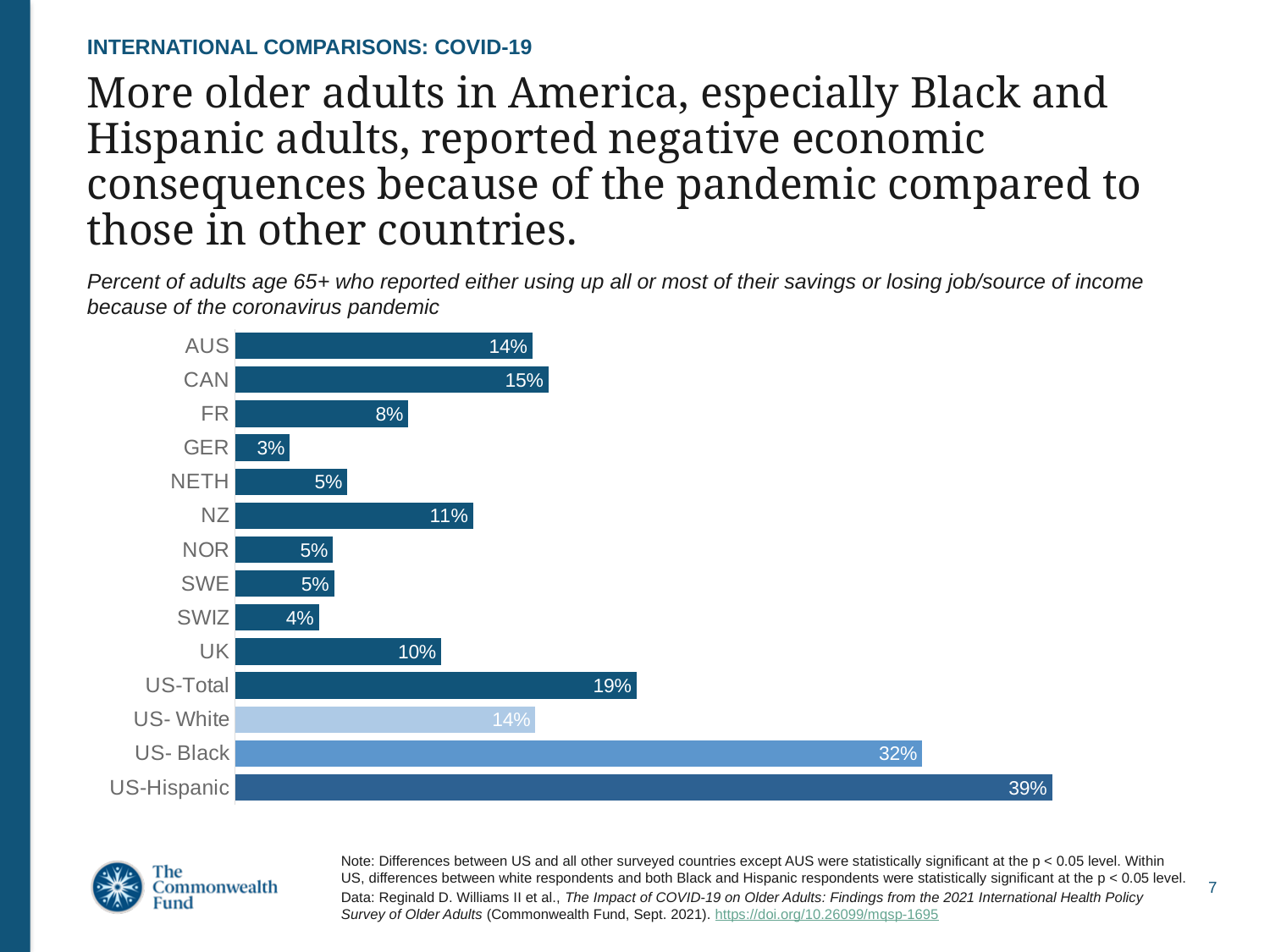
Which category has the highest value? US-Hispanic What is the difference between the values for US-Total and UK? 9% What is the value for US-Black? 32% What is the difference between the values for US-Hispanic and US-White? 25% Which is larger, the value for NZ or the value for FR? NZ Which is larger, the value for AUS or the value for GER? AUS What is the value for SWIZ? 4% What kind of chart is shown on the slide? Bar chart Which category has the lowest value? GER How many categories are shown in the chart? 14 What is the value for CAN? 15% What is the value for US-Total? 19%